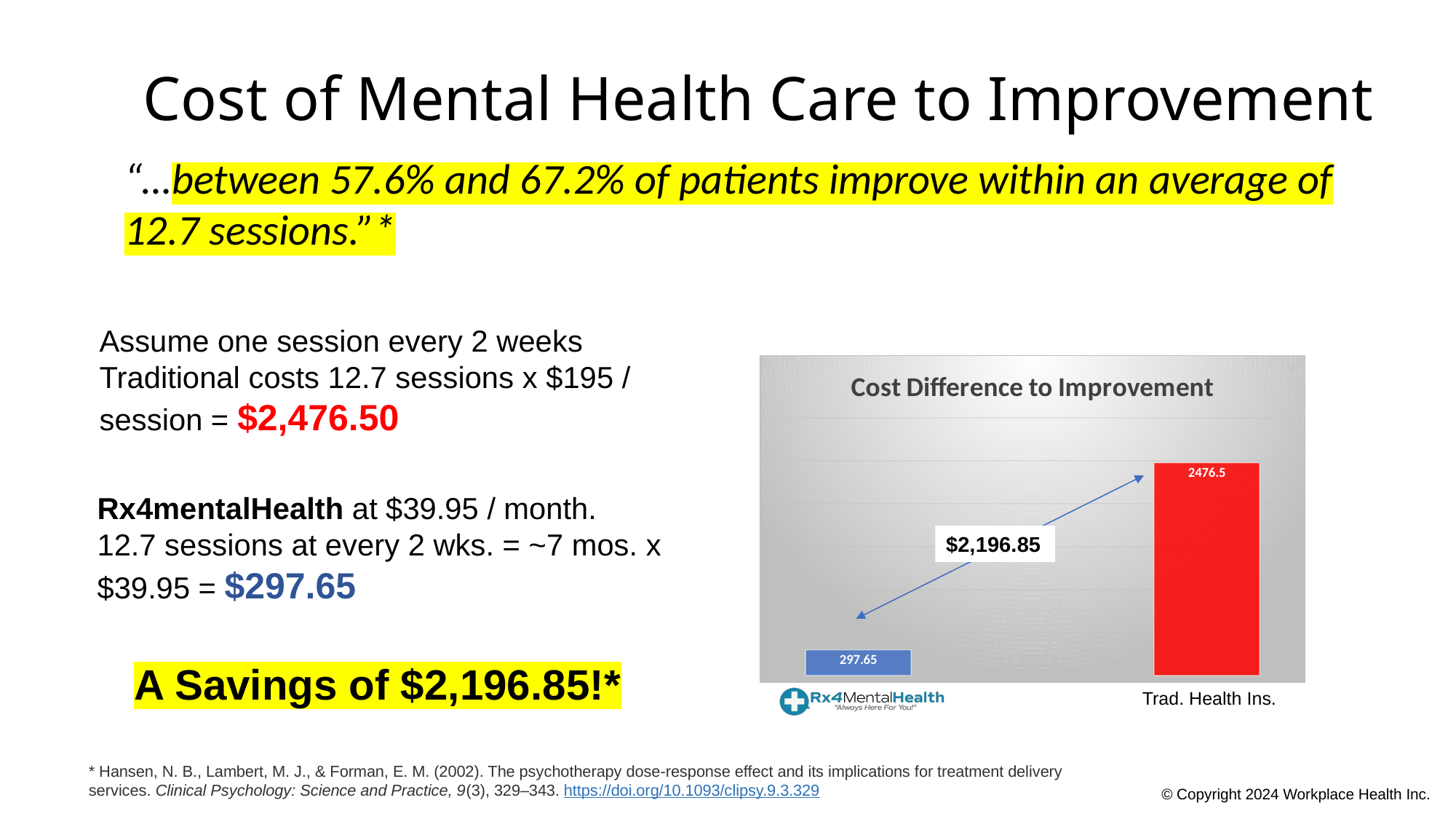
Which category has the lowest value in the Cost Difference to Improvement chart? Rx4MentalHealth What kind of chart is the Cost Difference to Improvement chart? bar chart In the Cost Difference to Improvement chart, which is larger: the value for Rx4MentalHealth or the value for Trad. Health Ins.? Trad. Health Ins. How many bars are plotted in the Cost Difference to Improvement chart? 2 What is the value shown for Rx4MentalHealth in the Cost Difference to Improvement chart? 297.65 What savings amount is annotated between the two bars in the Cost Difference to Improvement chart? $2,196.85 What is the value shown for Trad. Health Ins. in the Cost Difference to Improvement chart? 2476.5 Which category has the highest value in the Cost Difference to Improvement chart? Trad. Health Ins. What is the title of the chart on the slide? Cost Difference to Improvement